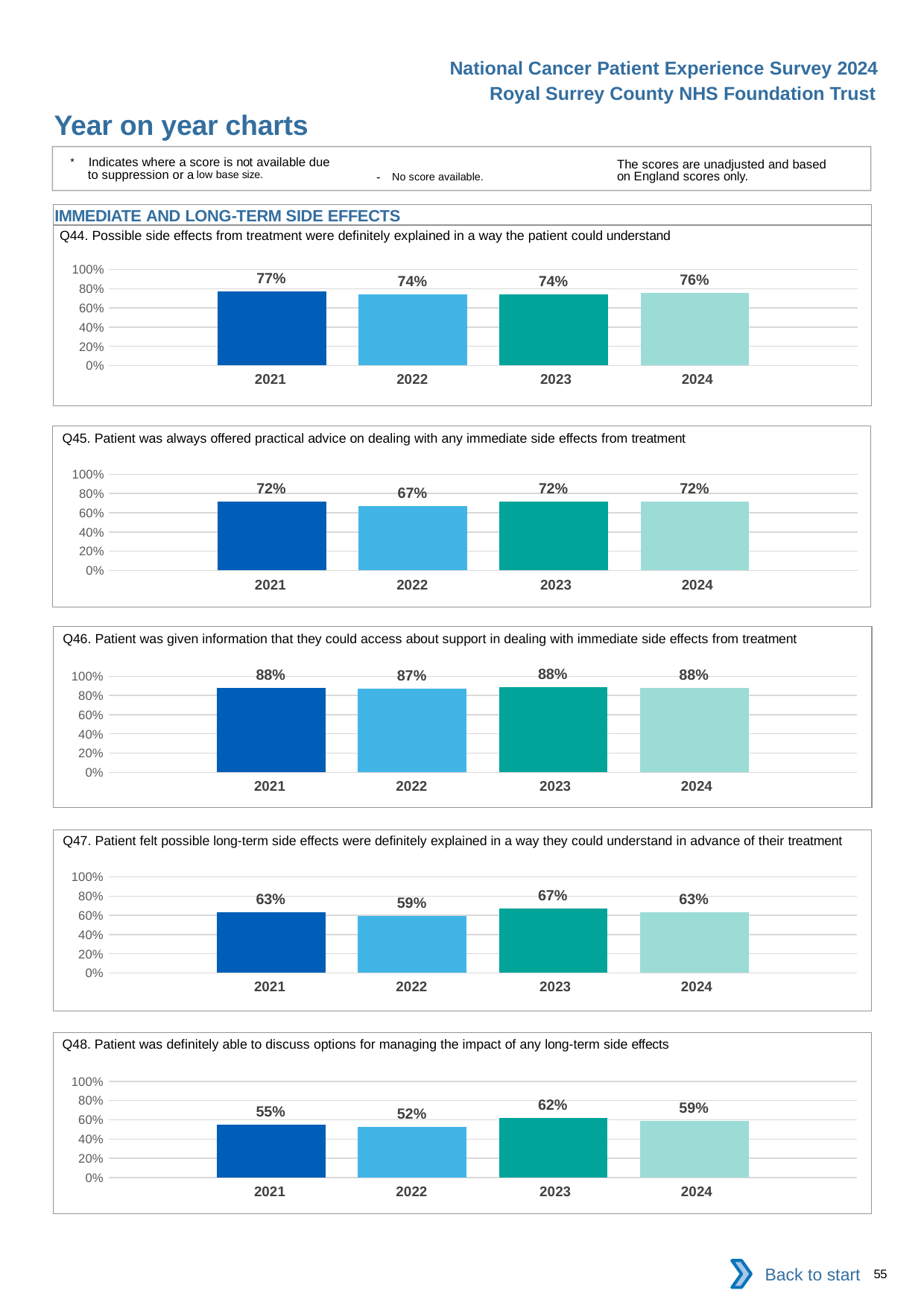
In the Q48 chart, what is the value for 2024? 59% In the Q44 chart, what is the value for 2021? 77% In the Q44 chart, what is the difference between the 2021 value and the 2024 value? 1% In the Q47 chart, which year has the highest value? 2023 How many charts are shown on the slide? 5 In the Q48 chart, what is the difference between the 2023 value and the 2022 value? 10% In the Q47 chart, is the value for 2022 larger or smaller than the value for 2023? smaller How many years are shown on the x axis of the Q44 chart? 4 In the Q48 chart, is the value for 2021 greater or less than 60%? less What kind of chart is the Q45 chart? bar chart In the Q46 chart, what is the value for 2022? 87% In the Q45 chart, which year has the lowest value? 2022